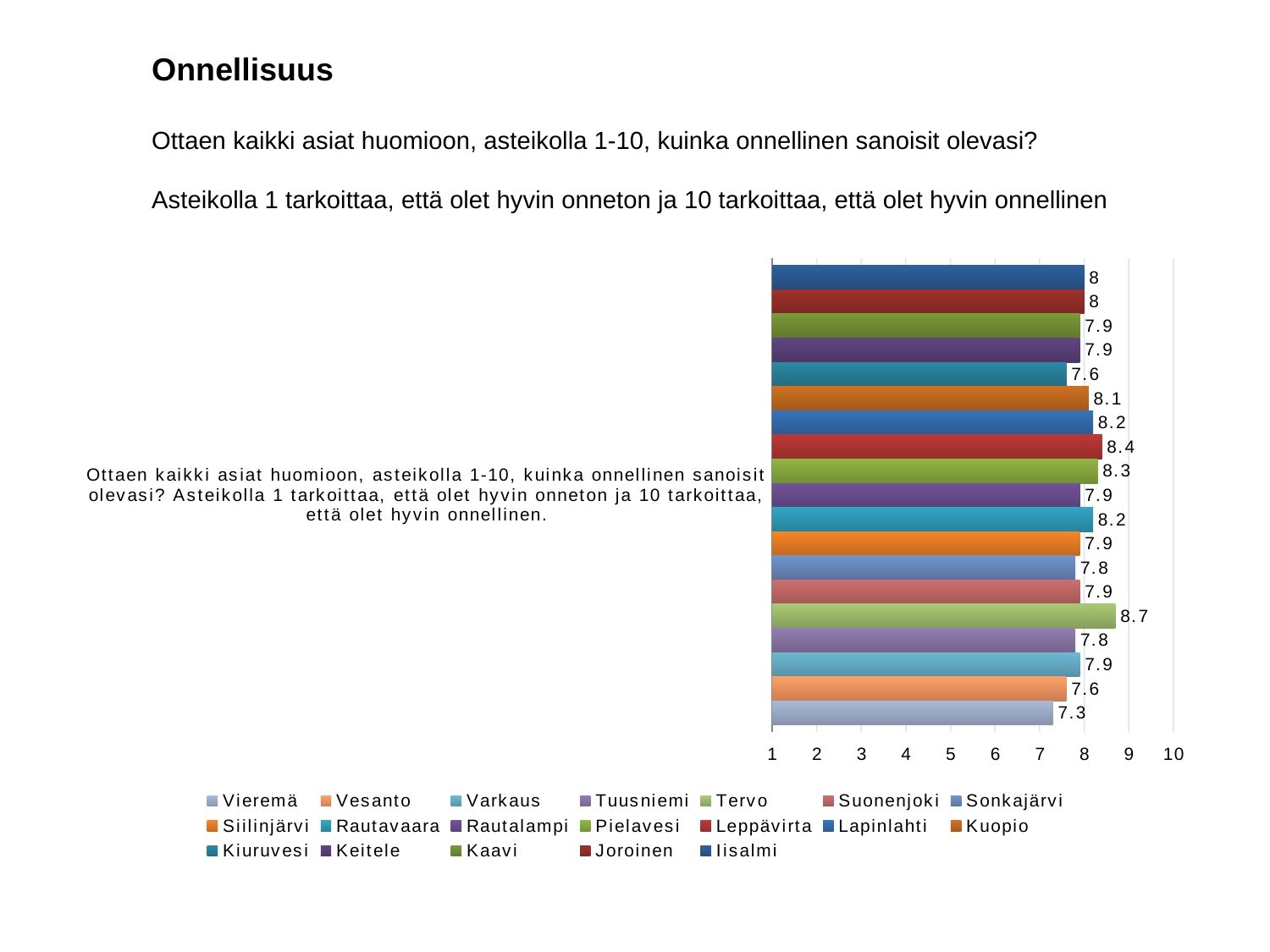
Which is larger, the value for Leppävirta or the value for Kuopio? Leppävirta What kind of chart is shown on the slide? bar chart Which municipality has the highest happiness value? Tervo How many bars are plotted in the chart? 19 What is the title of the slide? Onnellisuus What is the difference between the values for Tervo and Vieremä? 1.4 What is the value for Leppävirta? 8.4 What is the value for Vieremä? 7.3 Which municipality has the lowest happiness value? Vieremä How many series does the legend list? 19 What is the value for Kuopio? 8.1 What is the value for Tervo? 8.7